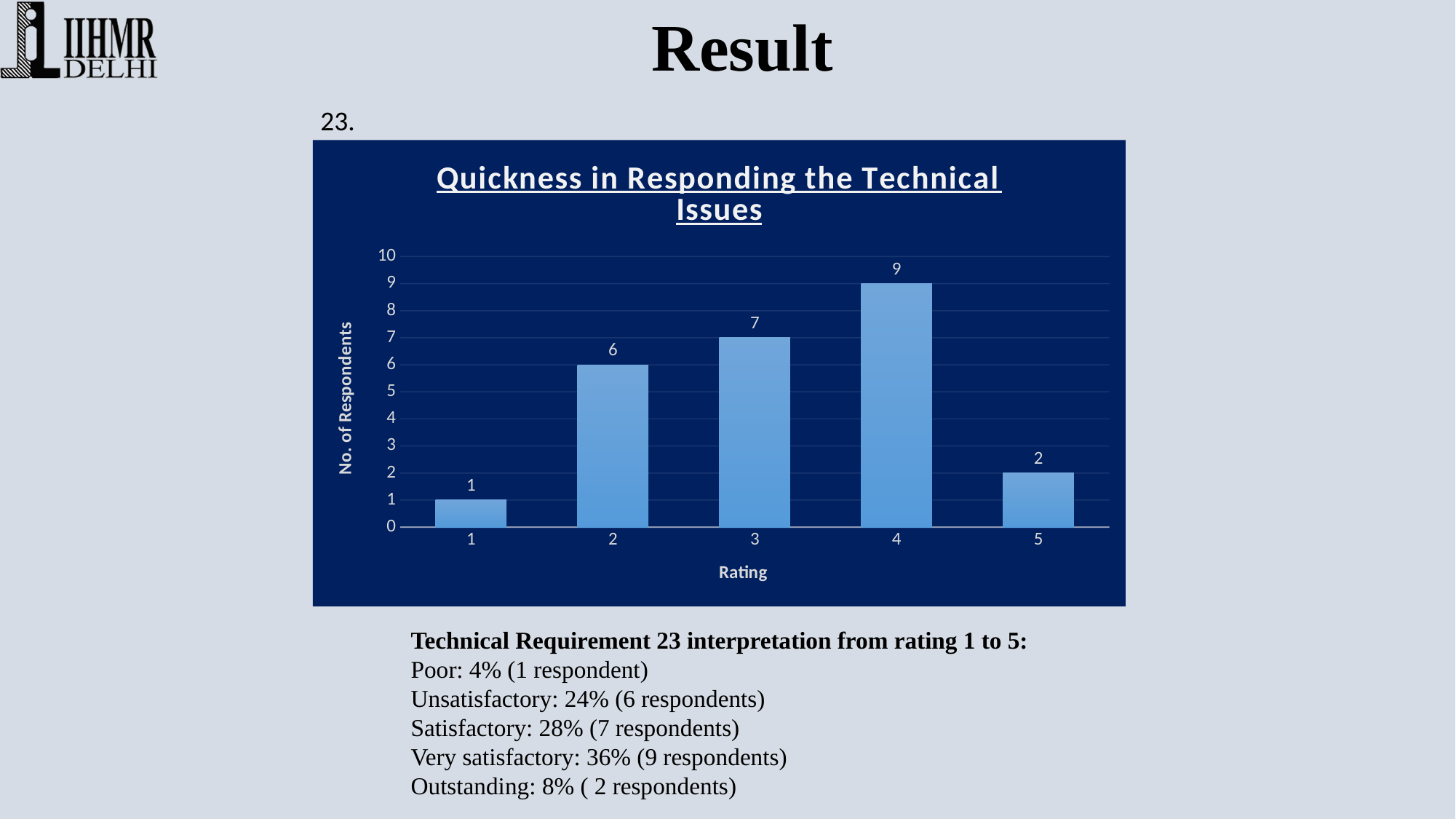
What is the number of respondents for rating 5? 2 What is the title of the chart? Quickness in Responding the Technical Issues How many rating categories are shown on the x axis? 5 What is the total number of respondents across all five ratings? 25 What is the difference in number of respondents between rating 4 and rating 2? 3 Which rating has the highest number of respondents? 4 What is the label of the y axis? No. of Respondents Which has more respondents, rating 3 or rating 5? Rating 3 Which rating has the lowest number of respondents? 1 What kind of chart is shown on the slide? Bar chart What is the number of respondents for rating 4? 9 What is the number of respondents for rating 1? 1